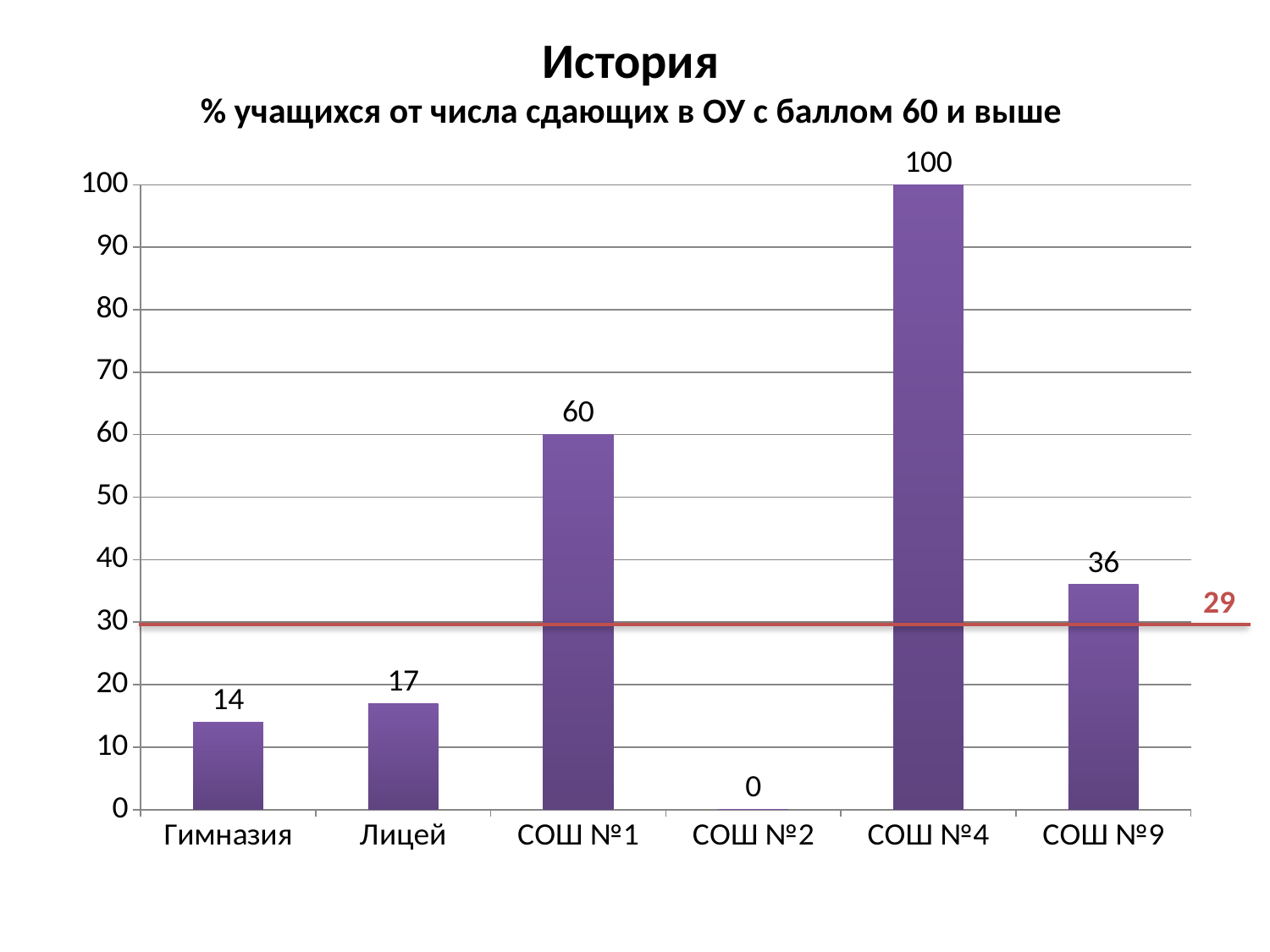
What is the value for СОШ №1? 60 What is the difference between the values for Лицей and Гимназия? 3 What is the value for СОШ №9? 36 How many categories are shown on the x axis? 6 Which category has the highest value? СОШ №4 What kind of chart is shown on the slide? bar chart Which is larger, the value for Лицей or the value for СОШ №9? СОШ №9 What is the value for Гимназия? 14 What is the difference between the values for СОШ №4 and СОШ №1? 40 Is the value for СОШ №1 greater or less than 50? greater Which category has the lowest value? СОШ №2 What value is labelled on the red horizontal line across the chart? 29